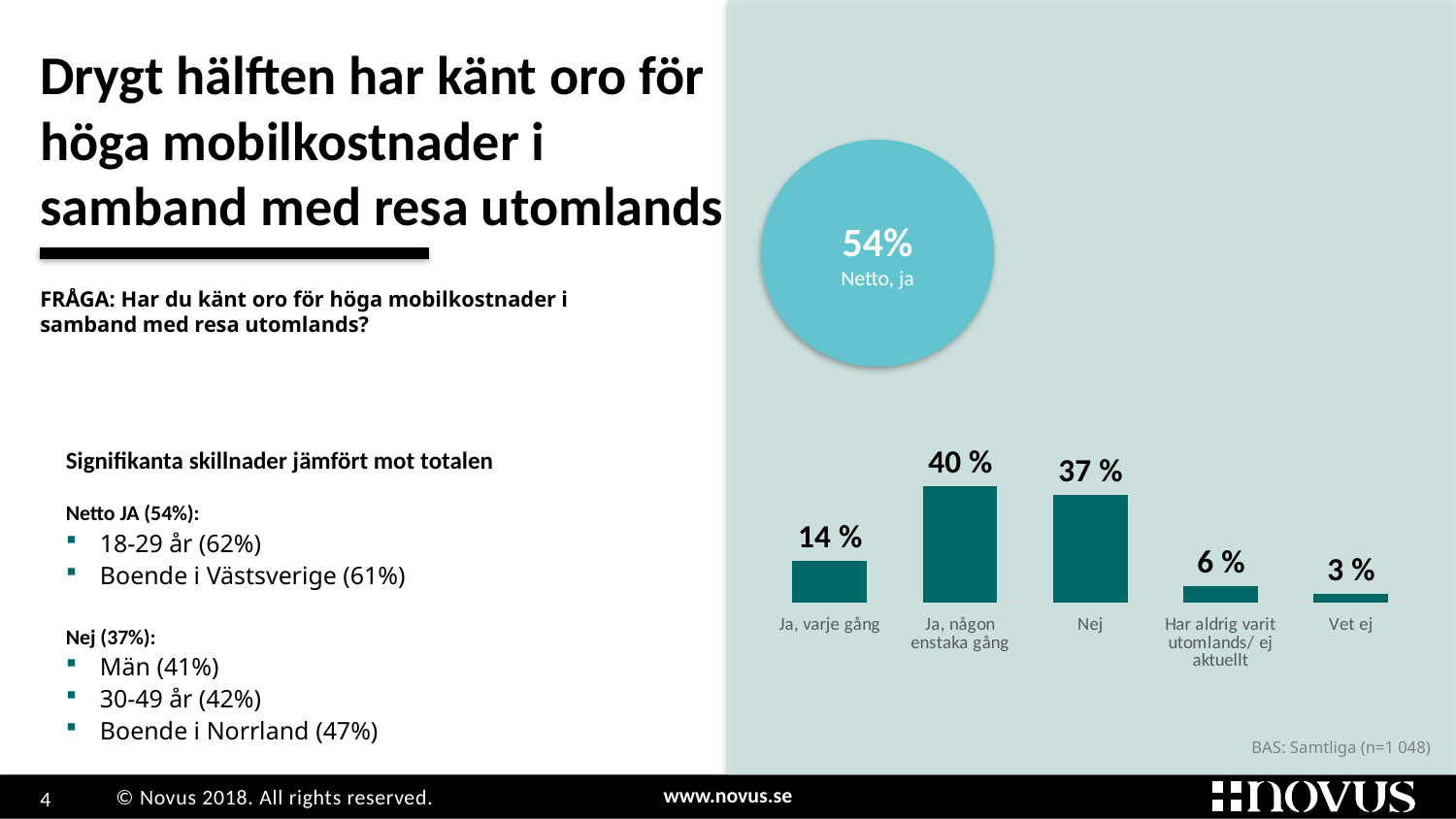
What is the value for "Har aldrig varit utomlands/ ej aktuellt"? 6 % How many categories are shown in the bar chart? 5 What percentage is shown in the circle labelled "Netto, ja"? 54% Which category has the lowest value? Vet ej What is the value for "Vet ej"? 3 % What is the value for "Ja, varje gång"? 14 % What kind of chart is shown on the slide? Bar chart Which category has the highest value? Ja, någon enstaka gång What is the value for "Nej"? 37 % What is the difference between "Ja, någon enstaka gång" and "Nej"? 3 % Which is larger, "Ja, varje gång" or "Nej"? Nej What is the sum of "Ja, varje gång" and "Ja, någon enstaka gång"? 54 %